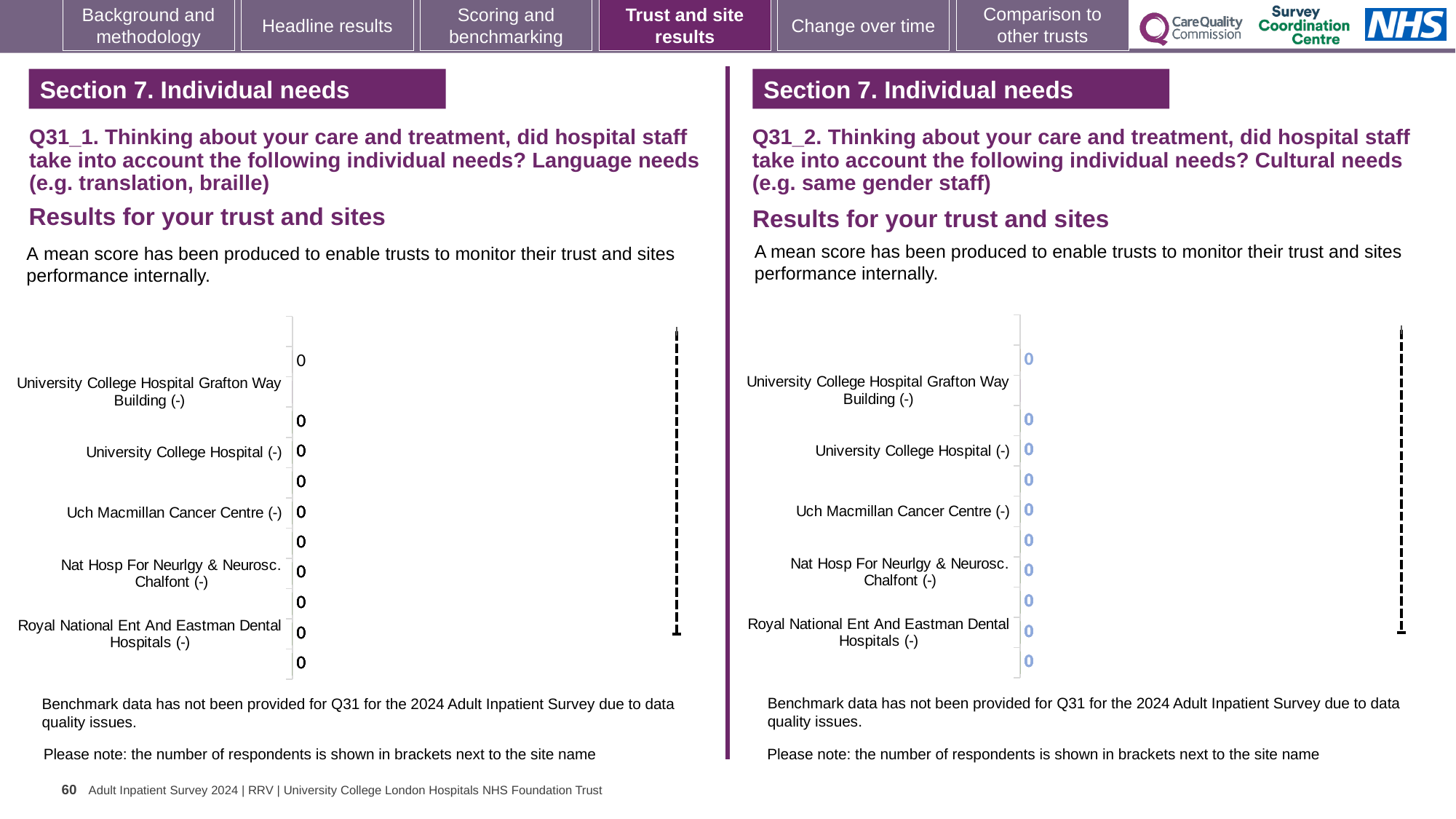
In the right chart (Q31_2, Cultural needs), what value is shown for Nat Hosp For Neurlgy & Neurosc. Chalfont (-)? 0 How many sites are listed on the left chart (Q31_1, Language needs)? 5 In the left chart (Q31_1, Language needs), what value is shown for University College Hospital (-)? 0 What kind of chart is the right chart (Q31_2, Cultural needs)? bar chart In the left chart (Q31_1, Language needs), what value is shown for Uch Macmillan Cancer Centre (-)? 0 Which site is listed first (at the top) of the left chart (Q31_1, Language needs)? University College Hospital Grafton Way Building (-) In the left chart (Q31_1, Language needs), what value is shown for University College Hospital Grafton Way Building (-)? 0 What kind of chart is the left chart (Q31_1, Language needs)? bar chart According to the note below the charts, why has benchmark data not been provided for Q31? Due to data quality issues How many sites are listed on the right chart (Q31_2, Cultural needs)? 5 In the right chart (Q31_2, Cultural needs), what is the difference between the values for University College Hospital (-) and Uch Macmillan Cancer Centre (-)? 0 In the right chart (Q31_2, Cultural needs), what value is shown for Royal National Ent And Eastman Dental Hospitals (-)? 0